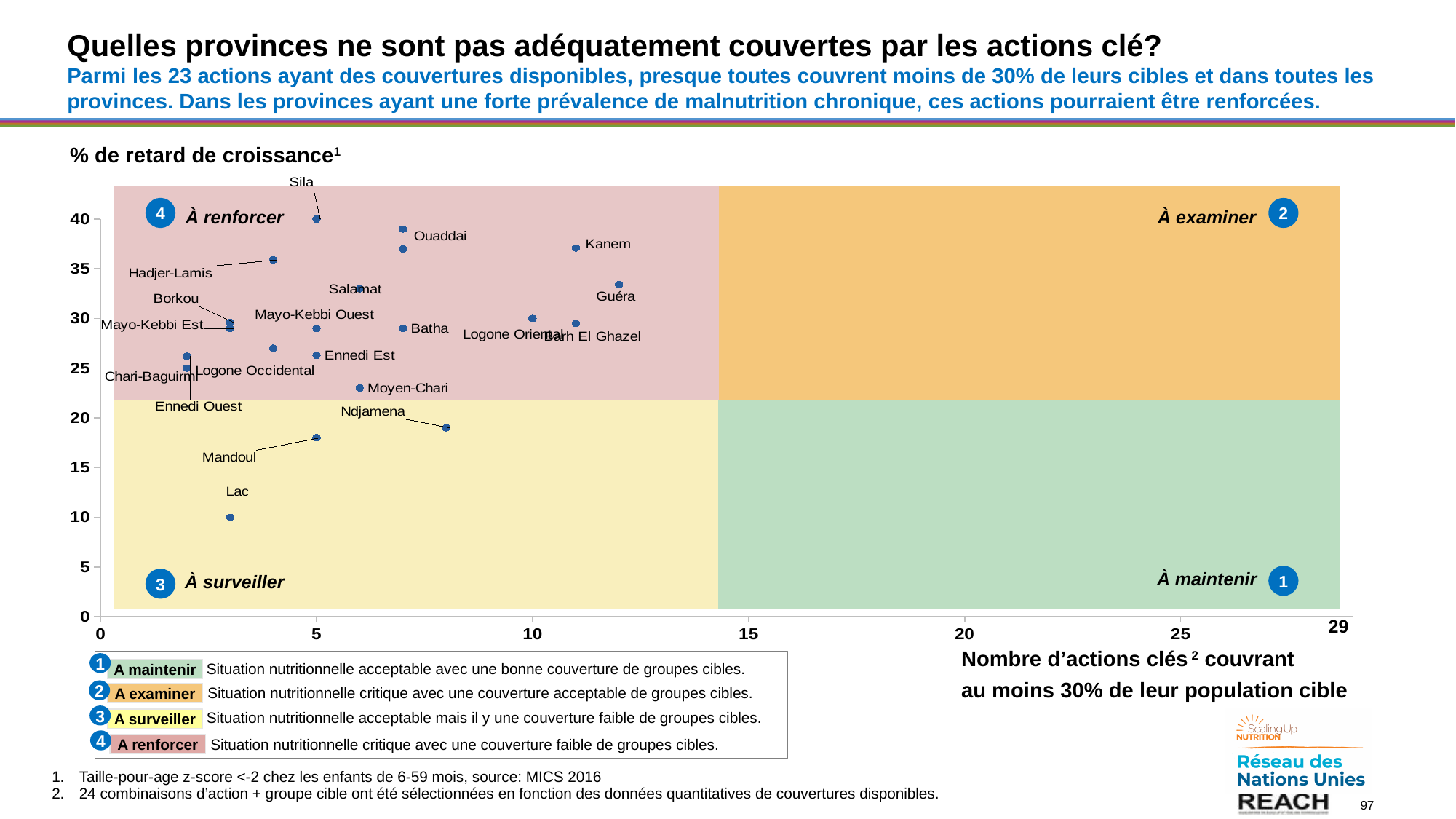
Is the number of key actions for Guéra greater or less than 10? greater Is the number of key actions for Lac greater or less than 5? less What kind of chart is shown on the slide? scatter chart Which has a higher % de retard de croissance, Kanem or Batha? Kanem Is the % de retard de croissance for Moyen-Chari greater or less than 25? less Which province covers more key actions, Guéra or Lac? Guéra Which province has the highest % de retard de croissance? Sila Which province has the lowest % de retard de croissance? Lac Which quadrant of the chart is labelled with the number 4? À renforcer